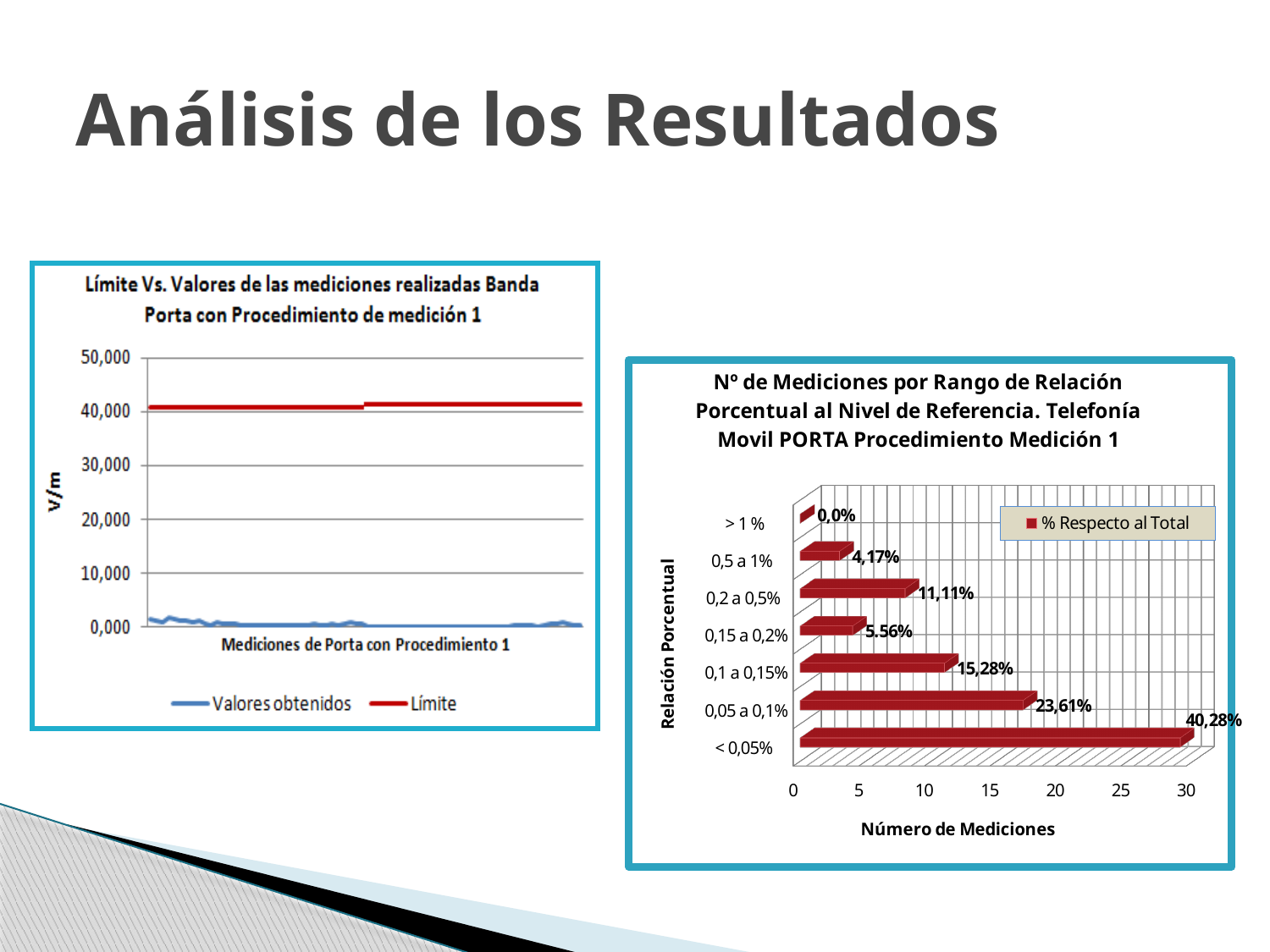
In the right-hand chart (Nº de Mediciones por Rango de Relación Porcentual), which is larger: the value for '0,2 a 0,5%' or the value for '0,1 a 0,15%'? 0,1 a 0,15% In the right-hand chart (Nº de Mediciones por Rango de Relación Porcentual), how many categories are shown on the vertical axis? 7 What kind of chart is the right-hand chart (Nº de Mediciones por Rango de Relación Porcentual)? Bar chart In the right-hand chart (Nº de Mediciones por Rango de Relación Porcentual), what is the data label for the category '0,05 a 0,1%'? 23,61% In the left-hand chart (Límite Vs. Valores de las mediciones realizadas), is the 'Límite' line greater or less than 30,000 V/m? greater In the right-hand chart (Nº de Mediciones por Rango de Relación Porcentual), what is the difference between the data labels for '< 0,05%' and '0,05 a 0,1%'? 16,67% In the left-hand chart (Límite Vs. Valores de las mediciones realizadas), how many series does the legend list? 2 In the right-hand chart (Nº de Mediciones por Rango de Relación Porcentual), what is the data label for the category '< 0,05%'? 40,28% In the left-hand chart (Límite Vs. Valores de las mediciones realizadas), what is the label of the y axis? V/m In the right-hand chart (Nº de Mediciones por Rango de Relación Porcentual), which category has the highest value? < 0,05% In the right-hand chart (Nº de Mediciones por Rango de Relación Porcentual), what is the data label for the category '0,15 a 0,2%'? 5,56% In the right-hand chart (Nº de Mediciones por Rango de Relación Porcentual), which category has the lowest value? > 1 %